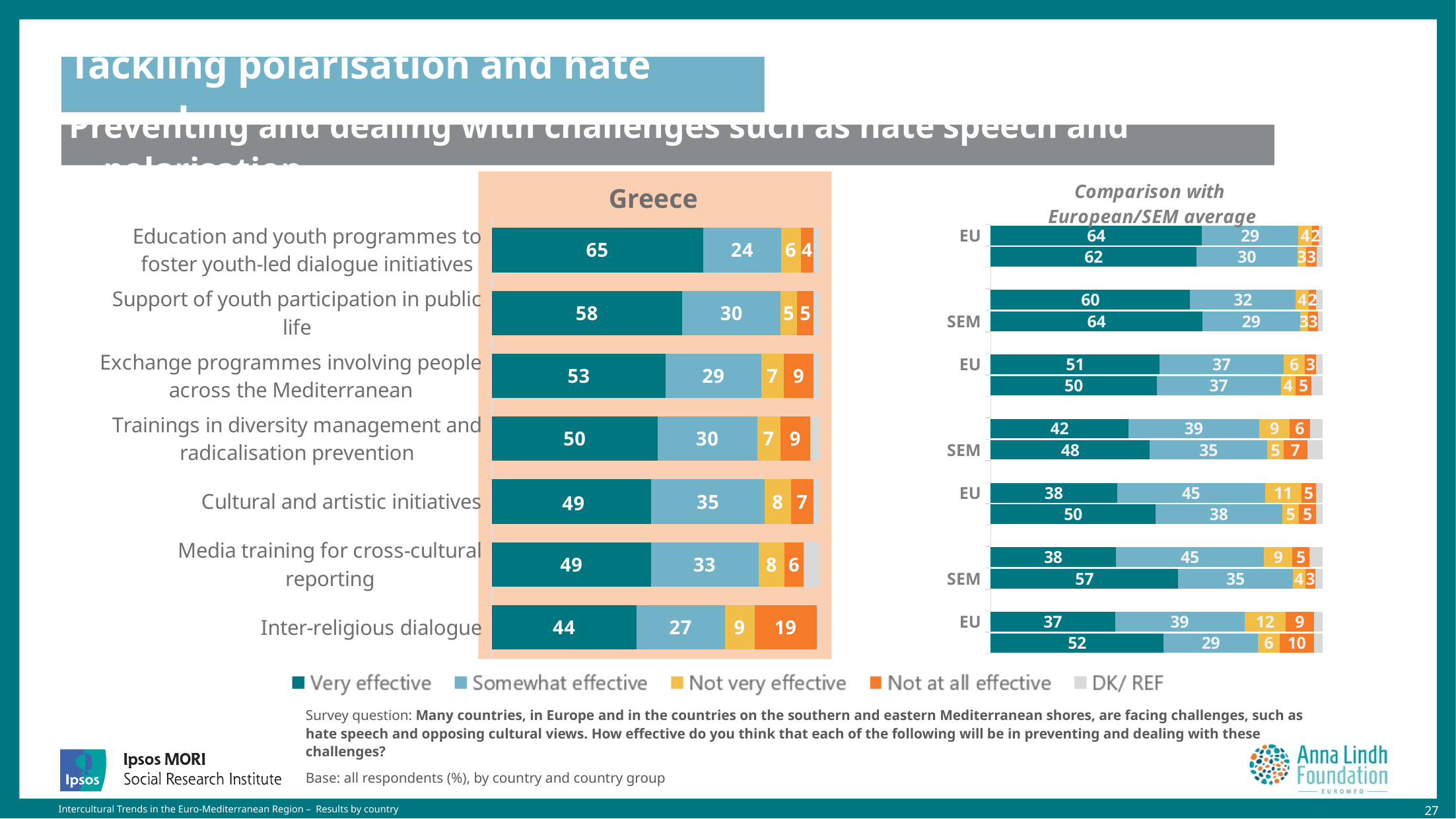
In the Greece chart, what is the combined Very effective and Somewhat effective value for Exchange programmes involving people across the Mediterranean? 82 In the Greece chart, what percentage rated Inter-religious dialogue as Not at all effective? 19 How many series does the legend list? 5 In the Greece chart, what is the difference between the Very effective values for Education and youth programmes and Support of youth participation in public life? 7 In the Greece chart, which measure has the highest Very effective value? Education and youth programmes to foster youth-led dialogue initiatives How many measures (categories) are listed in the Greece chart? 7 In the Comparison with European/SEM average chart, what is the EU Very effective value for Education and youth programmes (top bar)? 64 In the Greece chart, what percentage rated Inter-religious dialogue as Very effective? 44 What kind of chart is the Greece chart? Stacked bar chart In the Greece chart, what is the Not very effective value for Cultural and artistic initiatives? 8 In the Greece chart, which measure has the lowest Very effective value? Inter-religious dialogue In the Greece chart, which has the larger Somewhat effective value: Cultural and artistic initiatives or Media training for cross-cultural reporting? Cultural and artistic initiatives